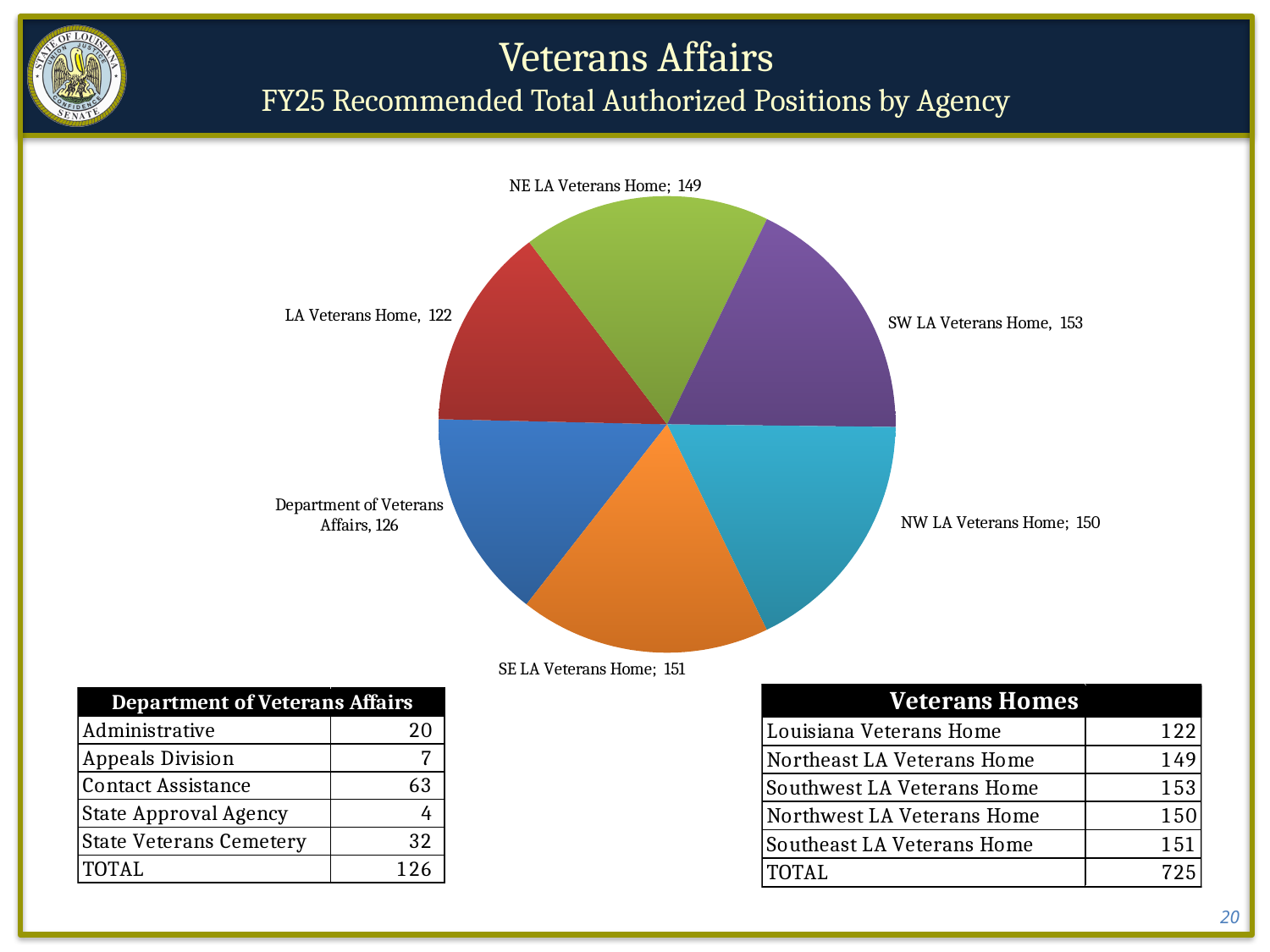
What is the value for SW LA Veterans Home in the pie chart? 153 What type of chart is shown on the slide? pie chart Which slice of the pie chart has the highest value? SW LA Veterans Home What is the total of all the values shown in the pie chart? 851 Which slice of the pie chart has the lowest value? LA Veterans Home How many slices does the pie chart have? 6 What is the value for Department of Veterans Affairs in the pie chart? 126 What is the value for NE LA Veterans Home in the pie chart? 149 What colour is the SW LA Veterans Home slice in the pie chart? purple Which is larger in the pie chart, NW LA Veterans Home or NE LA Veterans Home? NW LA Veterans Home What is the difference between the values for SE LA Veterans Home and Department of Veterans Affairs? 25 What is the difference between the values for SW LA Veterans Home and LA Veterans Home? 31